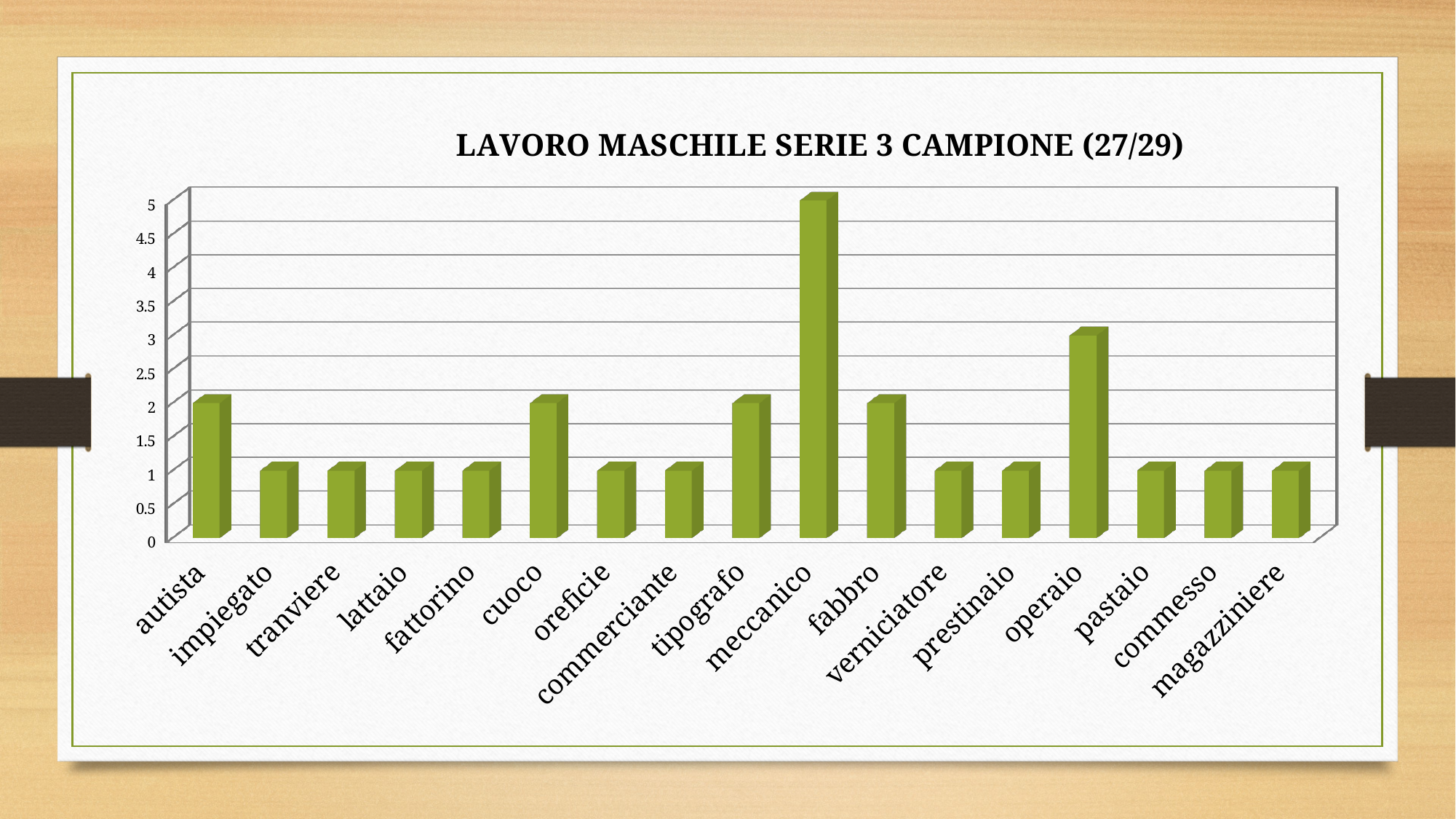
What is the value for impiegato? 1 What colour are the bars in the chart? green How many categories are shown on the x axis of the chart? 17 What is the value for autista? 2 What is the difference between the values for meccanico and operaio? 2 What is the title of the chart? LAVORO MASCHILE SERIE 3 CAMPIONE (27/29) What kind of chart is shown on the slide? bar chart Which category has the highest value in the chart? meccanico Is the value for operaio greater or less than 2? greater Which is larger, the value for cuoco or the value for oreficie? cuoco What is the value for operaio? 3 What is the value for meccanico? 5